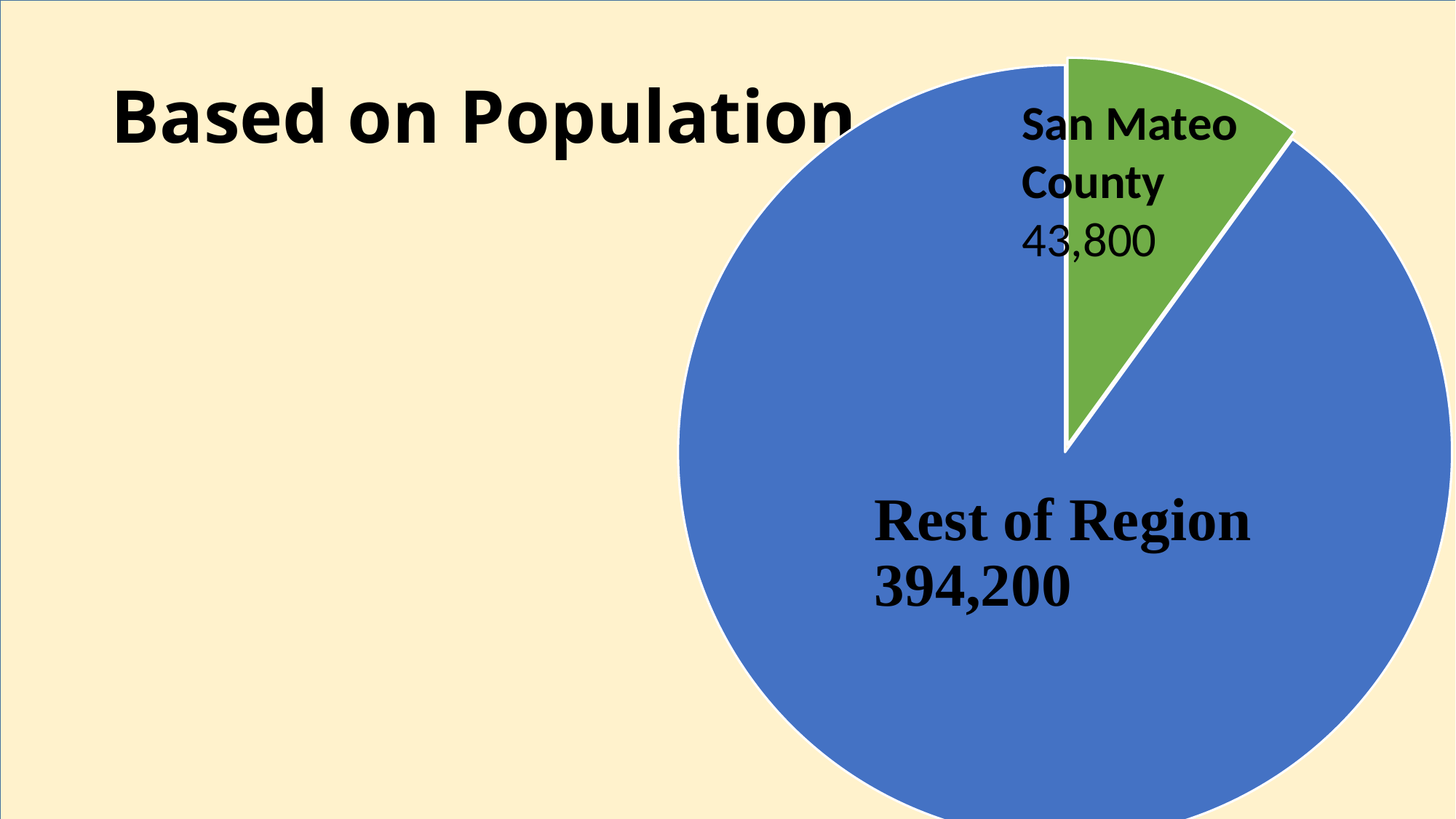
What is the value shown for San Mateo County? 43,800 What share of the pie does San Mateo County represent? 10% What is the difference between the Rest of Region value and the San Mateo County value? 350,400 What kind of chart is shown on the slide? pie chart What colour is the San Mateo County slice? green Which slice of the pie is the largest? Rest of Region What is the total of the two values shown in the pie chart? 438,000 How many slices does the pie chart have? 2 What is the title of the slide containing the pie chart? Based on Population What is the value shown for Rest of Region? 394,200 Which slice of the pie is the smallest? San Mateo County Which is larger, the value for San Mateo County or the value for Rest of Region? Rest of Region